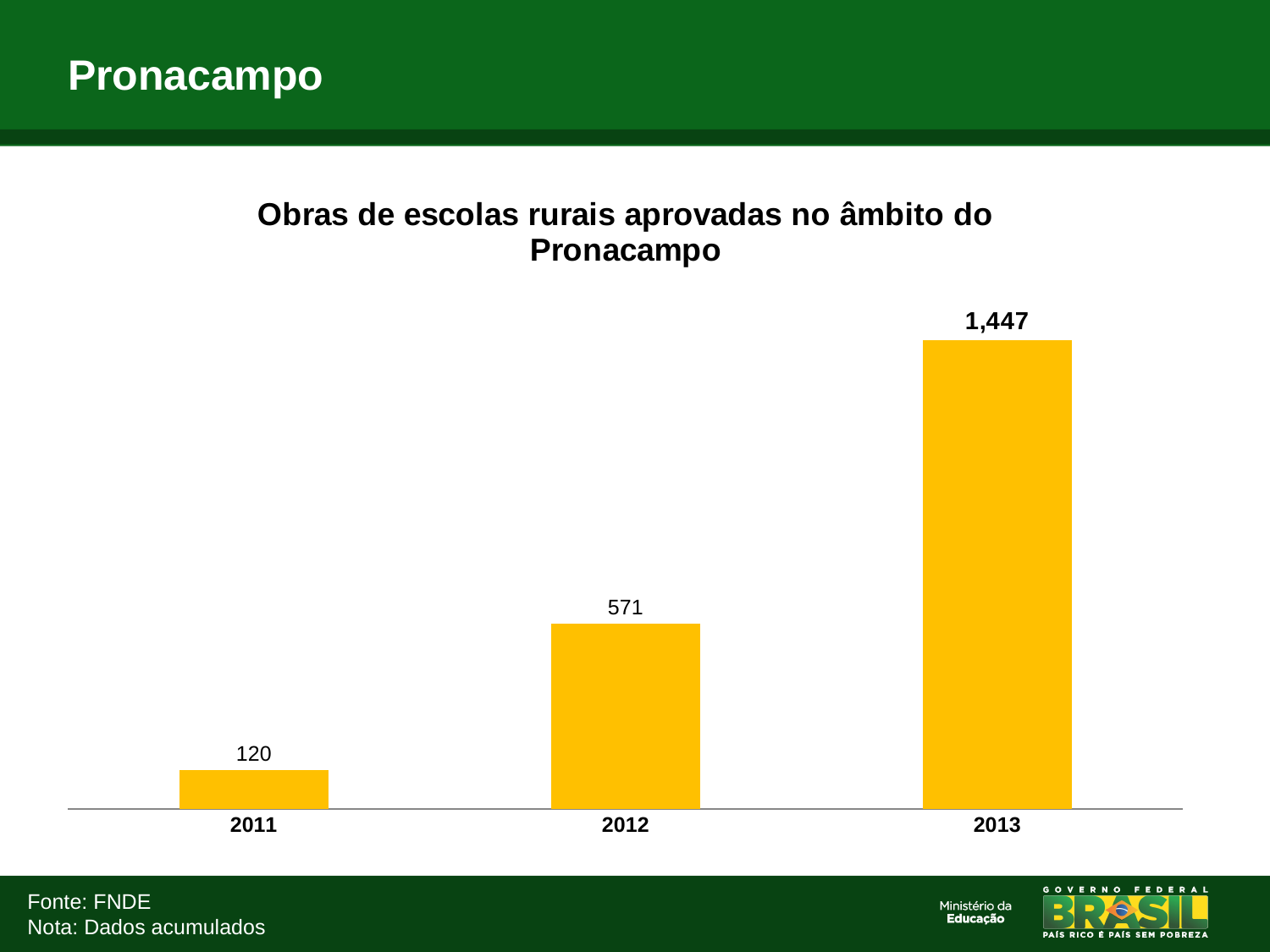
What is the title of the chart? Obras de escolas rurais aprovadas no âmbito do Pronacampo Which is larger, the value for 2012 or the value for 2011? 2012 What is the difference between the values for 2013 and 2012? 876 What is the value for 2012? 571 Which year has the highest value? 2013 Which year has the lowest value? 2011 Do the values rise or fall from 2011 to 2013? Rise What is the difference between the values for 2012 and 2011? 451 What kind of chart is this? Bar chart How many years are shown on the x axis? 3 What is the value for 2011? 120 What is the value for 2013? 1,447